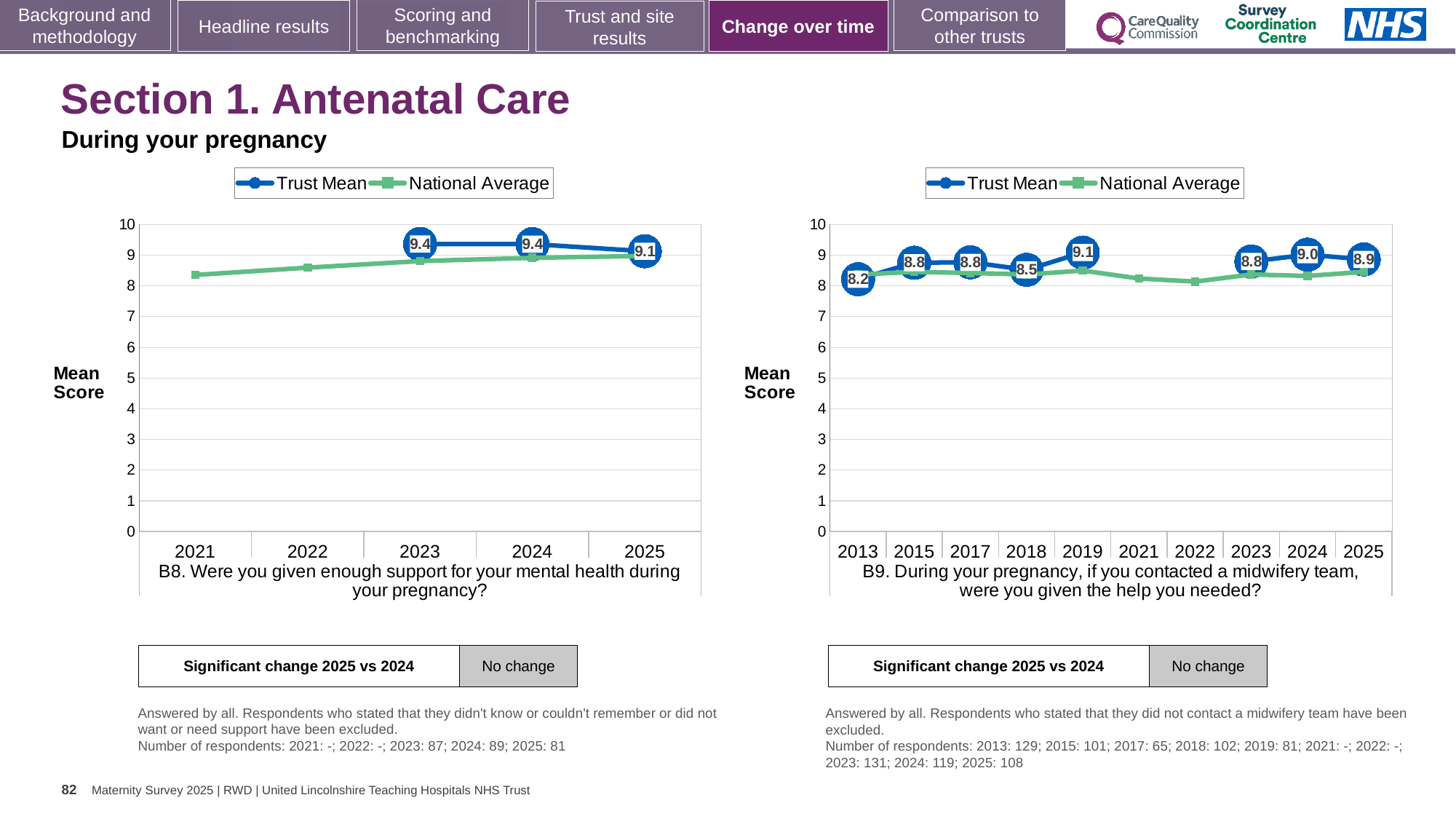
In the B9 chart on the right, which year has the highest Trust Mean? 2019 What type of chart is the B8 chart on the left? Line chart In the B9 chart on the right, which year has the lowest Trust Mean? 2013 In the B9 chart on the right, is the Trust Mean higher in 2024 or in 2025? 2024 In the B9 chart on the right, what is the difference between the Trust Mean for 2019 and 2018? 0.6 In the B8 chart on the left, what is the Trust Mean for 2023? 9.4 In the B8 chart on the left, how many years are shown on the x axis? 5 In the B9 chart on the right, what is the Trust Mean for 2013? 8.2 In the B8 chart on the left, is the National Average for 2021 greater or less than 9? less How many series does the legend of the B9 chart on the right list? 2 In the B8 chart on the left, what is the Trust Mean for 2025? 9.1 In the B8 chart on the left, what is the difference between the Trust Mean for 2024 and 2025? 0.3